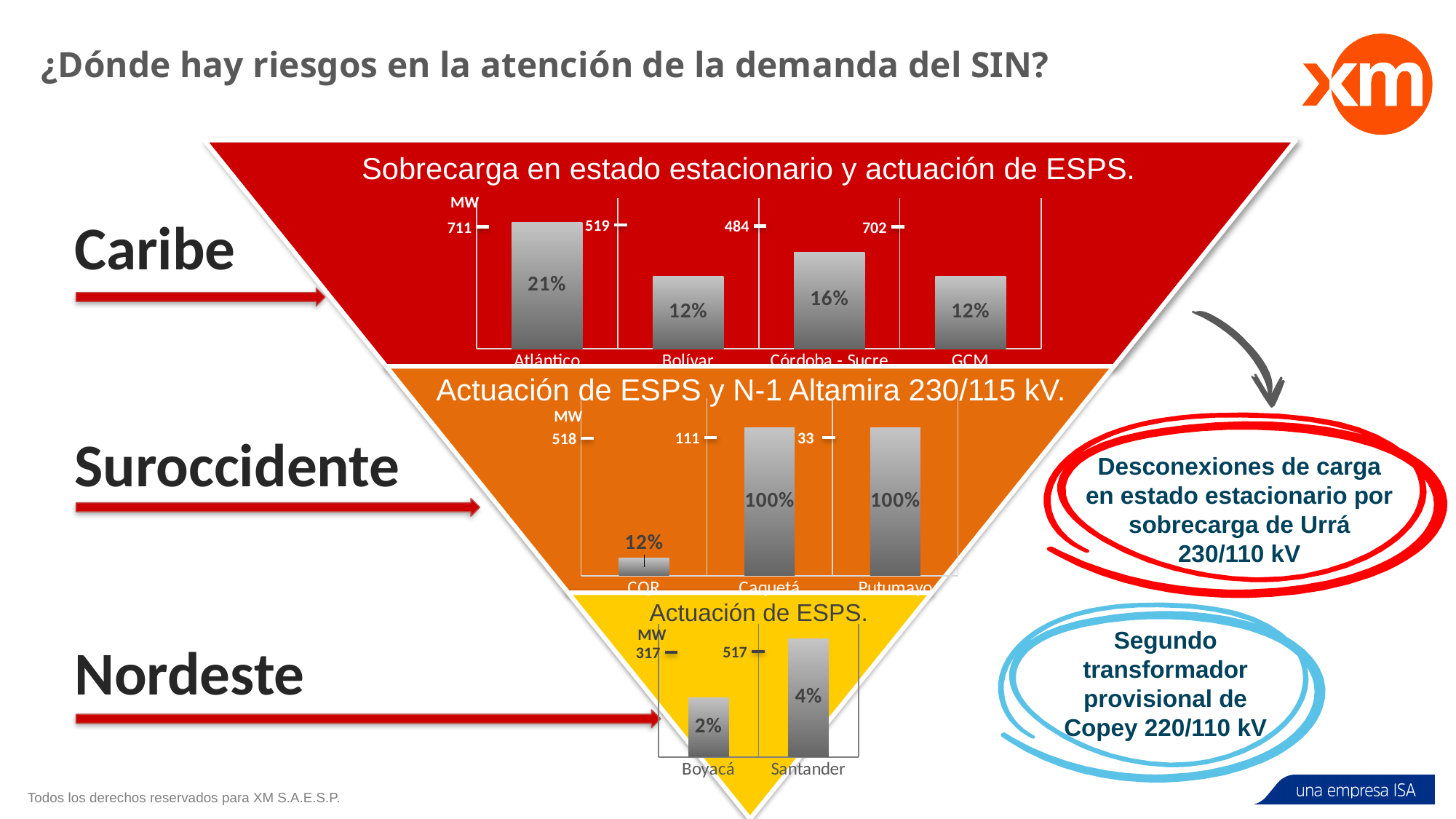
In the Caribe chart (top), which category has the highest value? Atlántico In the Caribe chart (top), what MW figure is printed at the top of the Atlántico axis? 711 In the Suroccidente chart (middle), which category has the lowest value? CQR In the Caribe chart (top), how many categories are plotted? 4 In the Nordeste chart (bottom), which is larger, the value for Boyacá or the value for Santander? Santander In the Nordeste chart (bottom, 'Actuación de ESPS.'), what is the value for Santander? 4% What kind of chart is the Nordeste chart (bottom)? bar chart In the Suroccidente chart (middle), how many categories are plotted? 3 In the Suroccidente chart (middle, 'Actuación de ESPS y N-1 Altamira 230/115 kV.'), what is the value for CQR? 12% In the Caribe chart (top), what is the difference between the values for Atlántico and Córdoba - Sucre? 5% In the Caribe chart (top), which is larger, the value for Bolívar or the value for Córdoba - Sucre? Córdoba - Sucre In the Caribe chart (top, 'Sobrecarga en estado estacionario y actuación de ESPS.'), what is the value for Atlántico? 21%